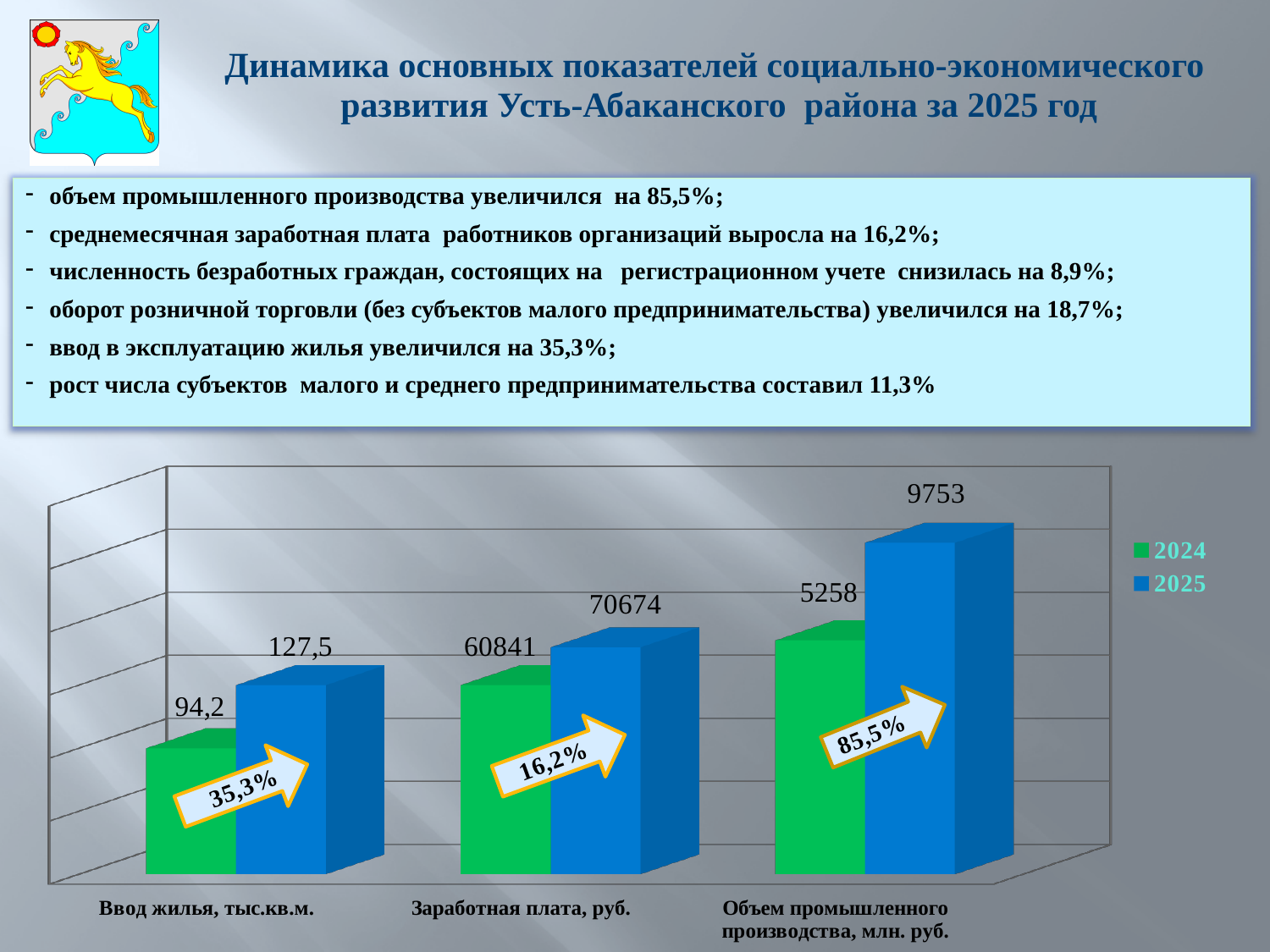
What is the 2025 value for Объем промышленного производства, млн. руб.? 9753 What is the 2025 value for Ввод жилья, тыс.кв.м.? 127,5 What is the 2024 value for Заработная плата, руб.? 60841 What is the difference between the 2025 and 2024 values for Объем промышленного производства, млн. руб.? 4495 What is the 2025 value for Заработная плата, руб.? 70674 How many series does the chart legend list? 2 Which is larger for Ввод жилья, тыс.кв.м.: the 2024 value or the 2025 value? 2025 What is the 2024 value for Ввод жилья, тыс.кв.м.? 94,2 How many categories are shown on the x axis of the chart? 3 What is the difference between the 2025 and 2024 values for Заработная плата, руб.? 9833 What kind of chart is shown on the slide? bar chart What percentage is shown on the arrow over the Заработная плата, руб. bars? 16,2%